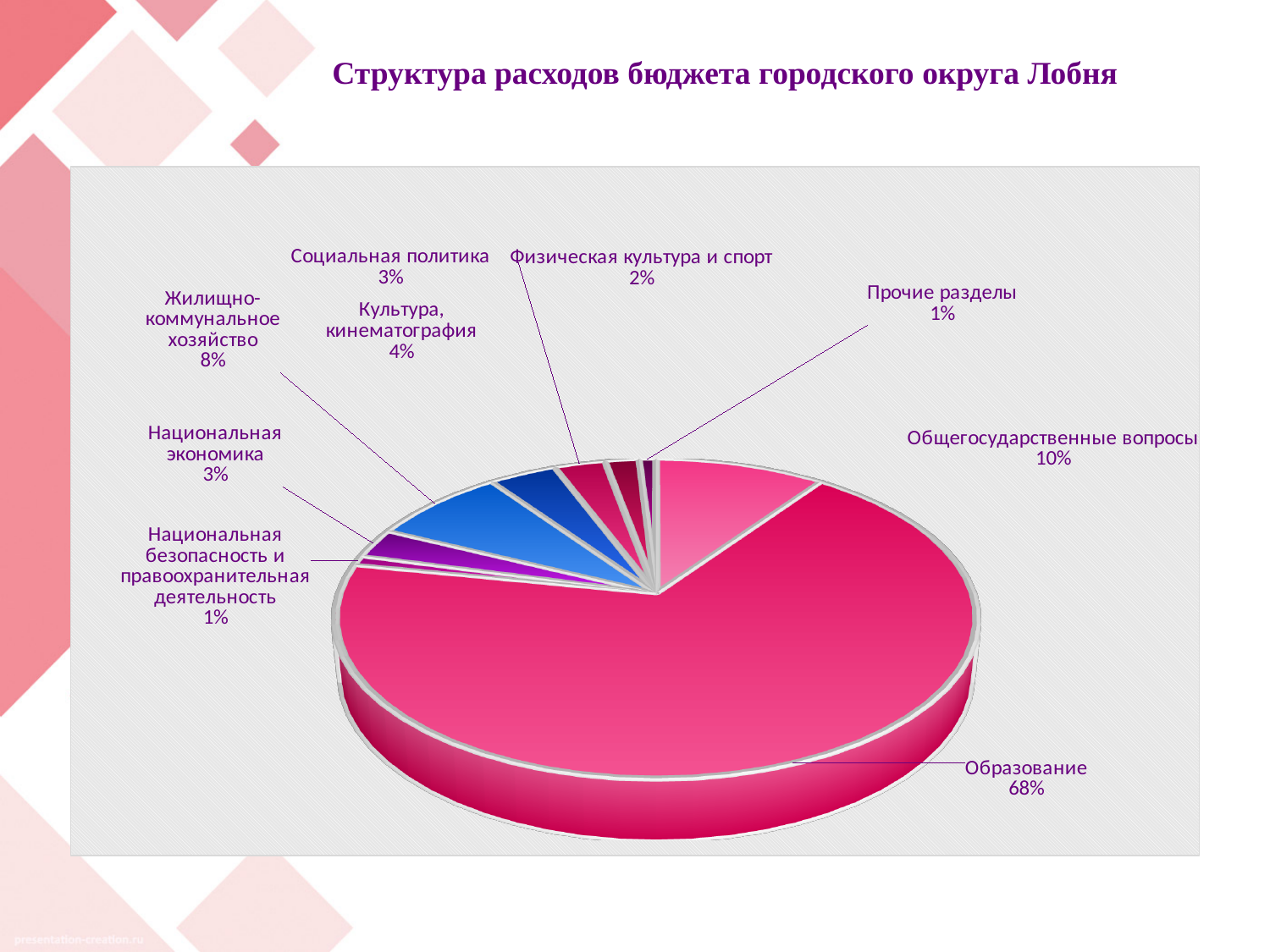
What percentage is shown for Физическая культура и спорт? 2% What is the value for Культура, кинематография? 4% What kind of chart is shown on the slide? Pie chart What is the difference between the shares of Образование and Общегосударственные вопросы? 58% What share of the budget expenditure goes to Образование? 68% How many categories (slices) does the pie chart have? 9 What is the title of the slide? Структура расходов бюджета городского округа Лобня What percentage is shown for Жилищно-коммунальное хозяйство? 8% Which category has the largest share of the pie? Образование Which is larger, the share for Жилищно-коммунальное хозяйство or for Культура, кинематография? Жилищно-коммунальное хозяйство What is the combined share of Социальная политика and Национальная экономика? 6% What is the value shown for Общегосударственные вопросы? 10%